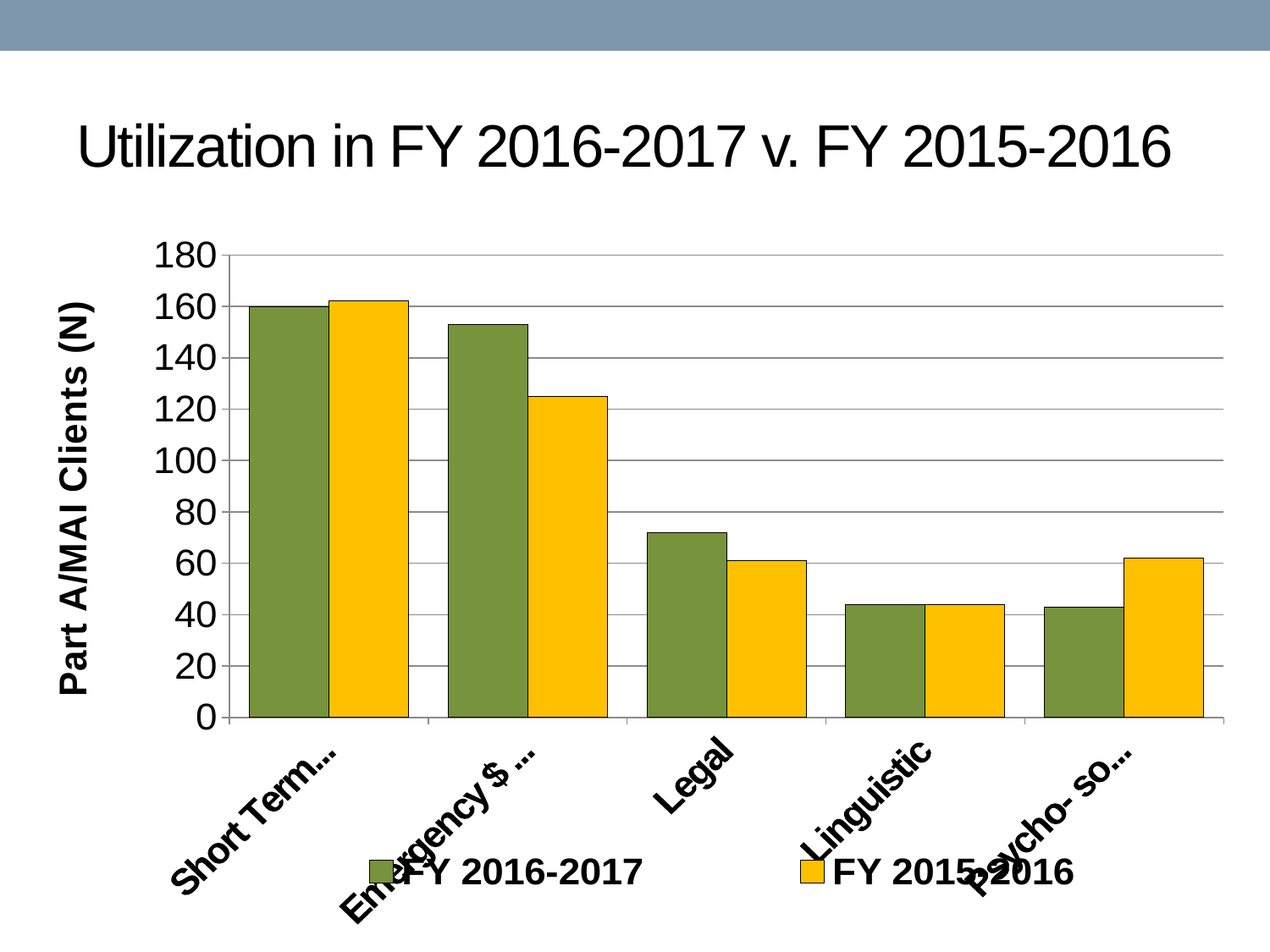
Is the FY 2015-2016 value for Linguistic greater or less than 20? greater Which category has the lowest FY 2015-2016 value, Legal or Linguistic? Linguistic Which category has the lowest FY 2015-2016 value? Linguistic Is the FY 2015-2016 value for Legal greater or less than 80? less What is the title of the vertical axis? Part A/MAI Clients (N) What are the two series named in the legend? FY 2016-2017 and FY 2015-2016 How many series does the legend list? 2 Is the FY 2016-2017 value for Legal greater or less than 60? greater For Legal, which series has the larger value, FY 2016-2017 or FY 2015-2016? FY 2016-2017 How many categories are plotted along the x axis? 5 What kind of chart is shown on the slide? Bar chart